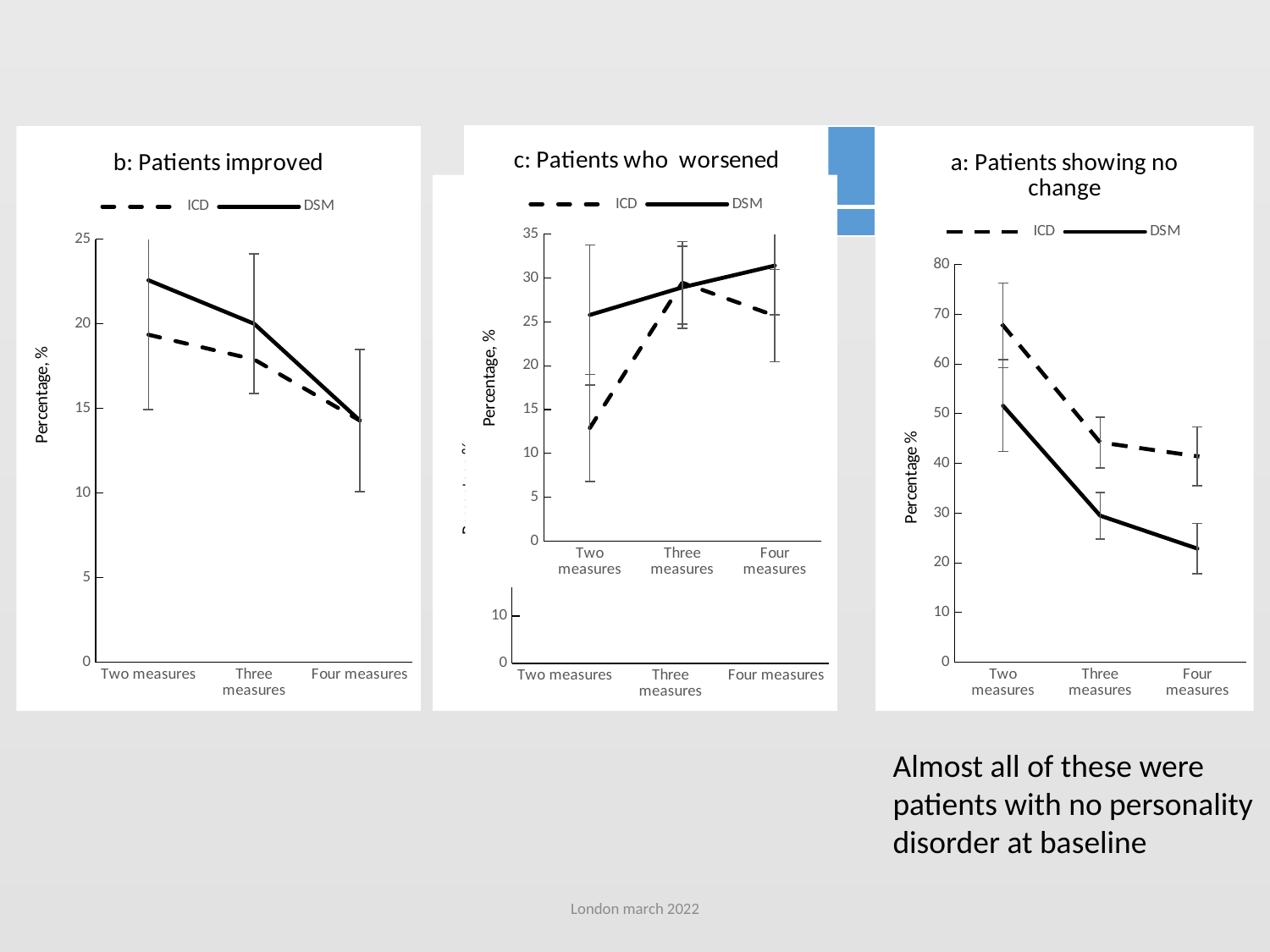
In "a: Patients showing no change", which series is drawn with a dashed line? ICD In "c: Patients who worsened", which series has the larger value at Two measures, ICD or DSM? DSM How many categories are on the x axis of "c: Patients who worsened"? 3 In "a: Patients showing no change", is the ICD value at Two measures greater or less than 60? greater In "b: Patients improved", is the DSM value at Two measures greater or less than 20? greater In "c: Patients who worsened", is the DSM value at Four measures greater or less than 30? greater How many series does the legend list in "a: Patients showing no change"? 2 In "b: Patients improved", do the DSM values rise or fall from Two measures to Four measures? fall What kind of chart is "b: Patients improved"? line chart